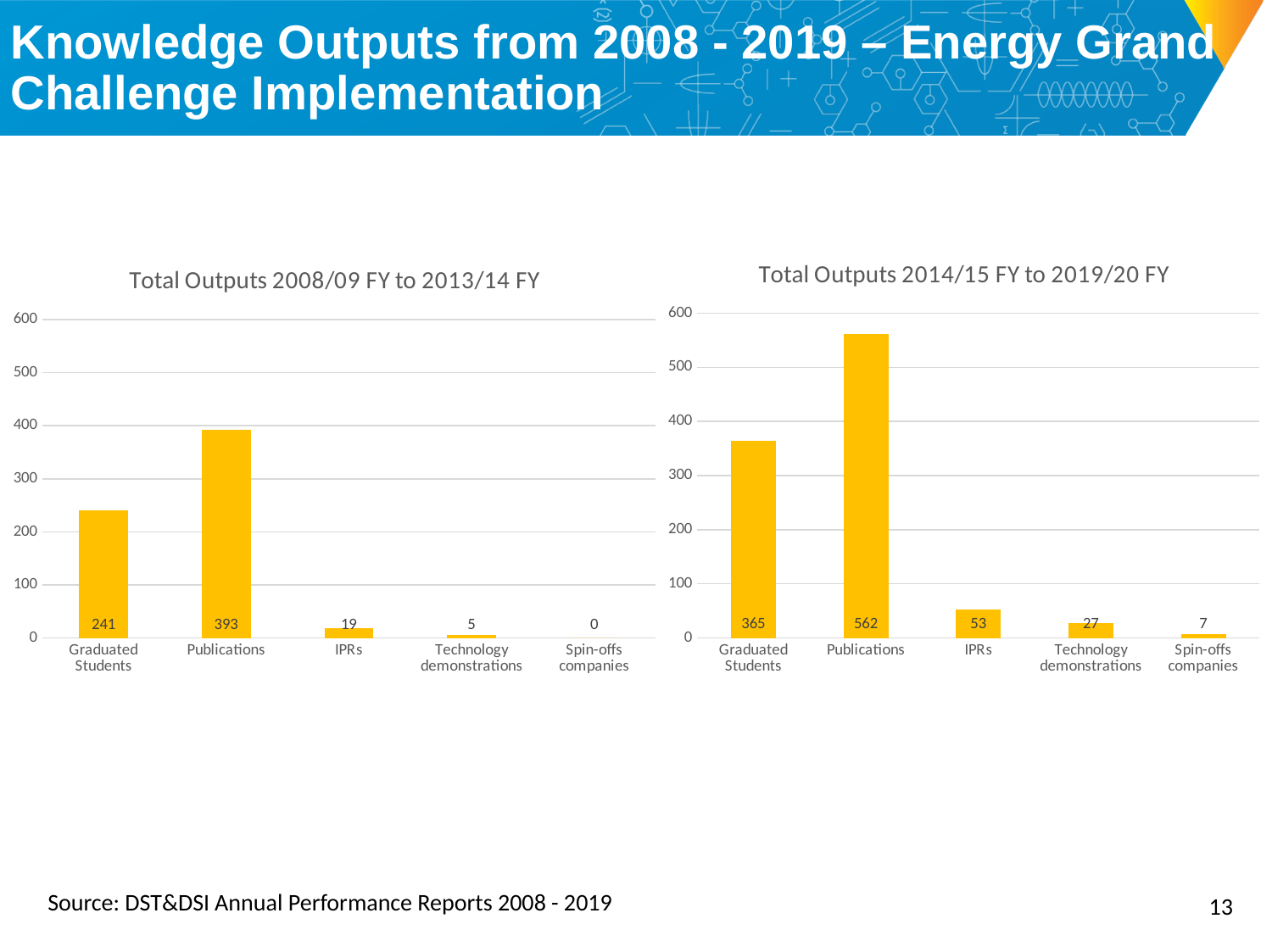
How many categories are shown in the 'Total Outputs 2014/15 FY to 2019/20 FY' chart? 5 In the 'Total Outputs 2014/15 FY to 2019/20 FY' chart, what is the value for IPRs? 53 In the 'Total Outputs 2008/09 FY to 2013/14 FY' chart, which category has the lowest value? Spin-offs companies In the 'Total Outputs 2008/09 FY to 2013/14 FY' chart, what is the value for Publications? 393 In the 'Total Outputs 2008/09 FY to 2013/14 FY' chart, which category has the highest value? Publications What is the title of the chart on the right side of the slide? Total Outputs 2014/15 FY to 2019/20 FY What type of chart is the 'Total Outputs 2008/09 FY to 2013/14 FY' chart? Bar chart In the 'Total Outputs 2014/15 FY to 2019/20 FY' chart, which category has the lowest value? Spin-offs companies In the 'Total Outputs 2014/15 FY to 2019/20 FY' chart, what is the difference between Publications and Graduated Students? 197 In the 'Total Outputs 2014/15 FY to 2019/20 FY' chart, what is the value for Graduated Students? 365 In the 'Total Outputs 2008/09 FY to 2013/14 FY' chart, what is the difference between Publications and Graduated Students? 152 Which is larger: Technology demonstrations in the 2008/09 to 2013/14 chart or Technology demonstrations in the 2014/15 to 2019/20 chart? 2014/15 to 2019/20 chart